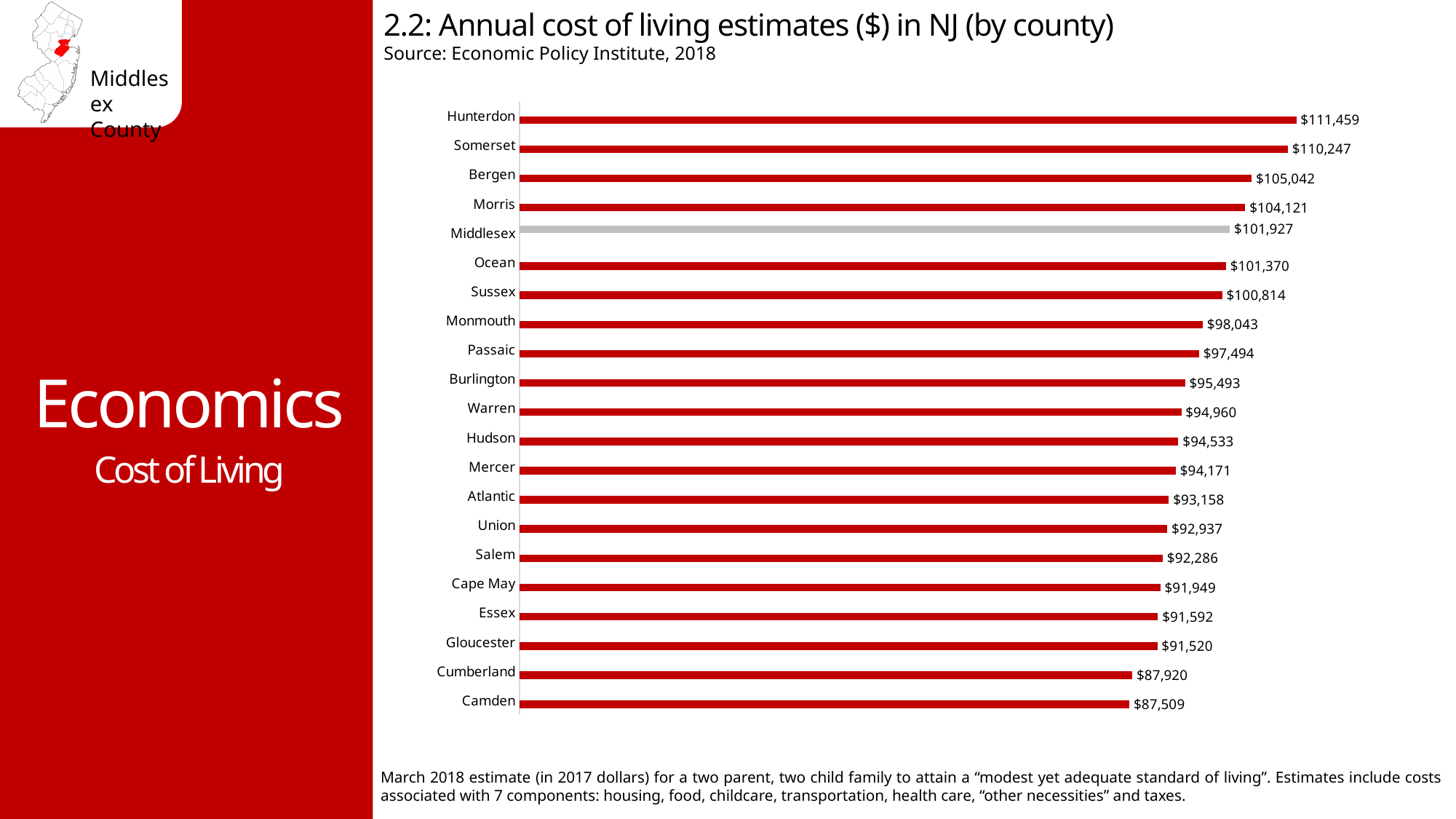
What is the difference between the cost of living estimates for Hunterdon and Somerset? $1,212 Which county has the lowest annual cost of living estimate? Camden Which county's bar is shown in gray instead of red? Middlesex What is the annual cost of living estimate for Bergen County? $105,042 Which county has the highest annual cost of living estimate? Hunterdon What is the annual cost of living estimate for Middlesex County? $101,927 What is the difference between the cost of living estimates for Middlesex and Camden? $14,418 Which county has a higher cost of living estimate, Morris or Ocean? Morris What type of chart is used on this slide? Bar chart What is the annual cost of living estimate for Camden County? $87,509 How many counties are shown in the chart? 21 Which county has a higher cost of living estimate, Cumberland or Gloucester? Gloucester